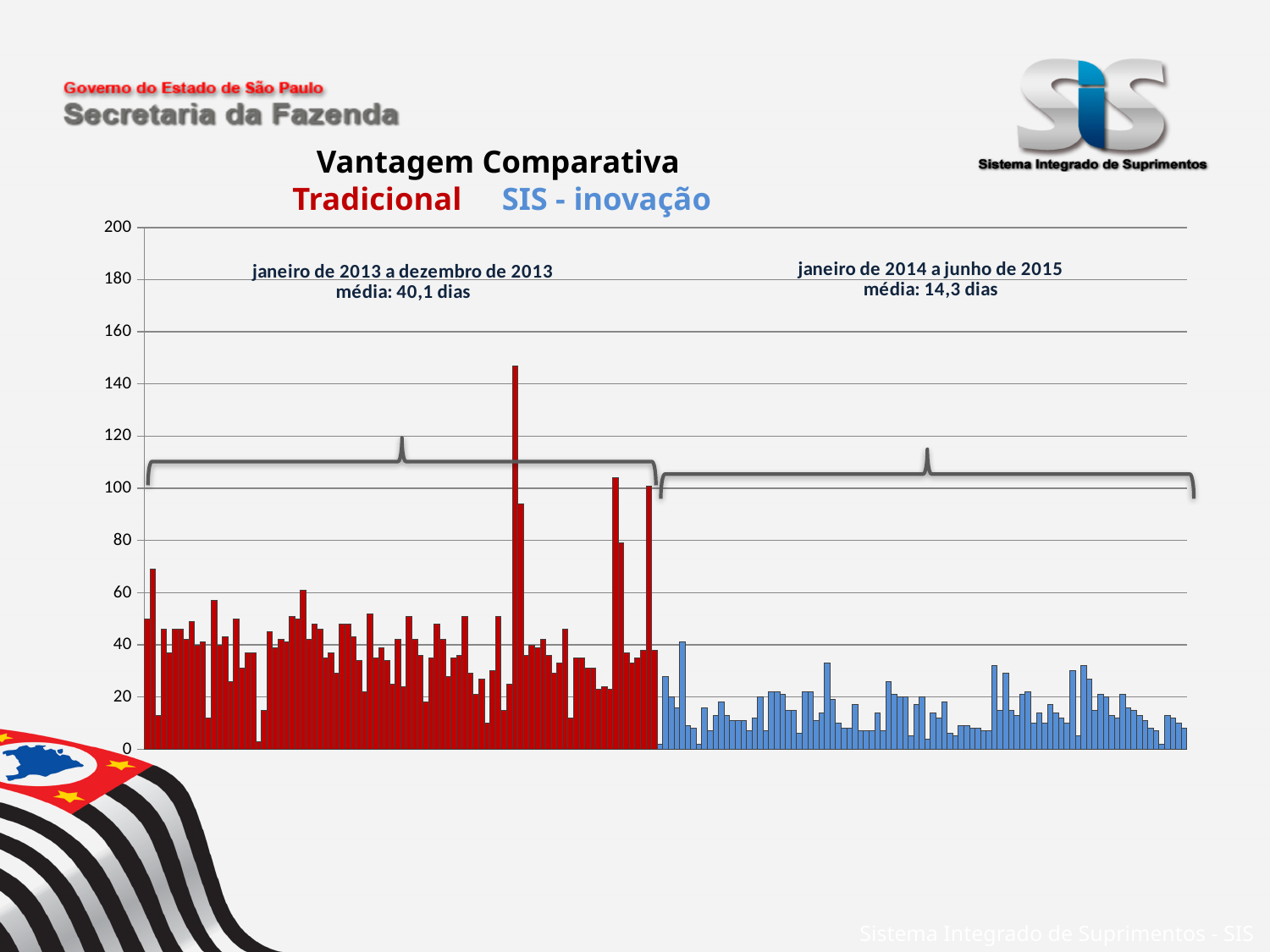
What colour are the bars for the SIS - inovação series? blue Is the tallest red (Tradicional) bar greater or less than 140? greater What average is stated for the period janeiro de 2013 a dezembro de 2013? 40,1 dias Which period has the higher stated average: janeiro de 2013 a dezembro de 2013 or janeiro de 2014 a junho de 2015? janeiro de 2013 a dezembro de 2013 What kind of chart is shown on the slide? bar chart Do the bar values generally fall or rise when moving from the Tradicional period to the SIS - inovação period along the x axis? fall How many series does the chart distinguish (as named above the chart)? 2 Is the tallest blue (SIS - inovação) bar greater or less than 60? less What average is stated for the period janeiro de 2014 a junho de 2015? 14,3 dias Which series contains the single highest bar on the chart, Tradicional or SIS - inovação? Tradicional What is the difference between the stated averages of the two periods (40,1 dias and 14,3 dias)? 25,8 dias What is the title of the chart? Vantagem Comparativa